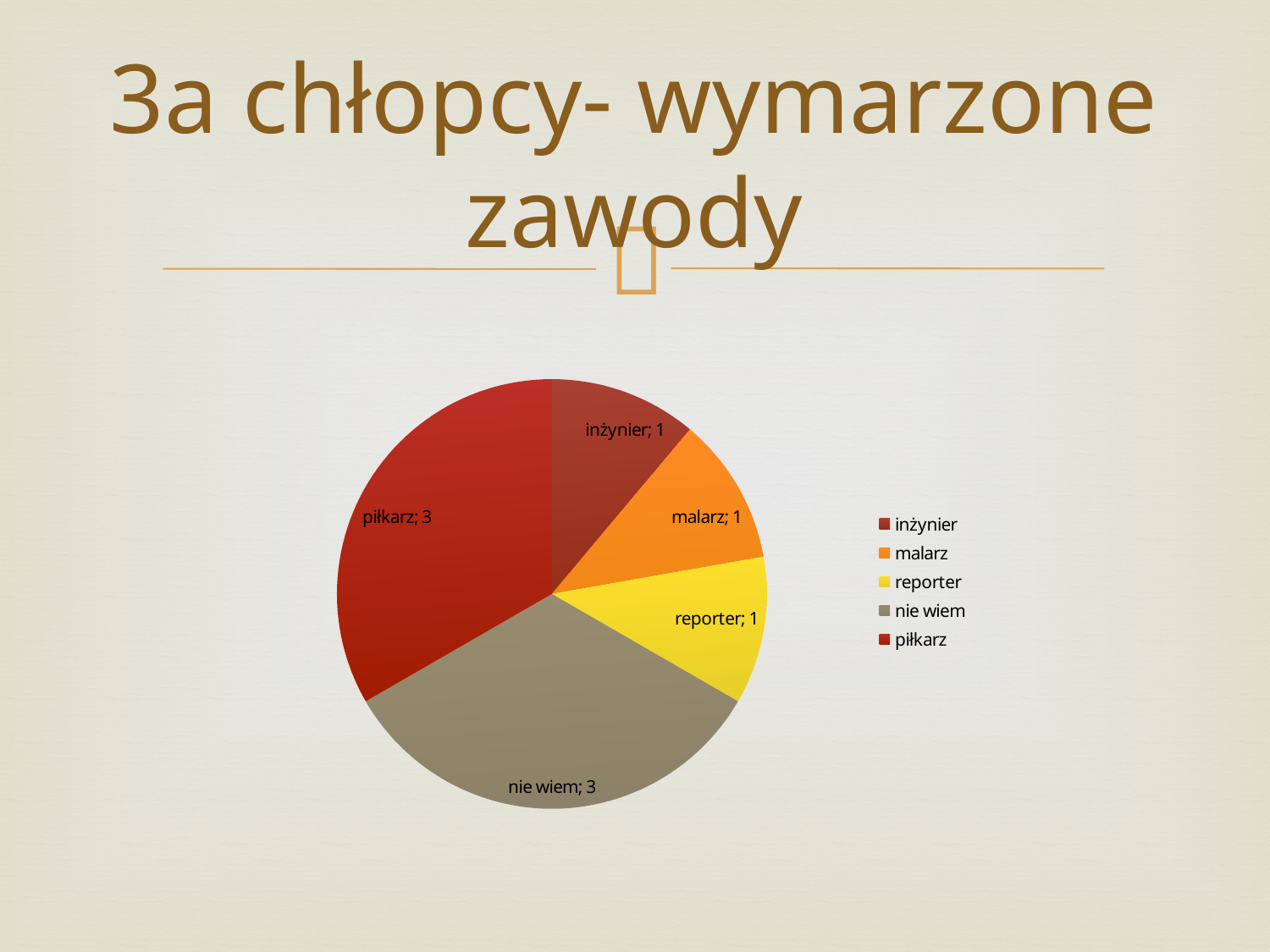
What is the value for reporter? 1 How many categories does the pie chart have? 5 What is the total of all the slices in the pie chart? 9 Which is larger, the value for piłkarz or the value for malarz? piłkarz What is the value for inżynier? 1 What is the value for piłkarz? 3 What is the difference between the value for nie wiem and the value for reporter? 2 What is the value for malarz? 1 What type of chart is shown on the slide? pie chart How many entries does the legend list? 5 What is the title of the slide containing the chart? 3a chłopcy- wymarzone zawody What is the value for nie wiem? 3